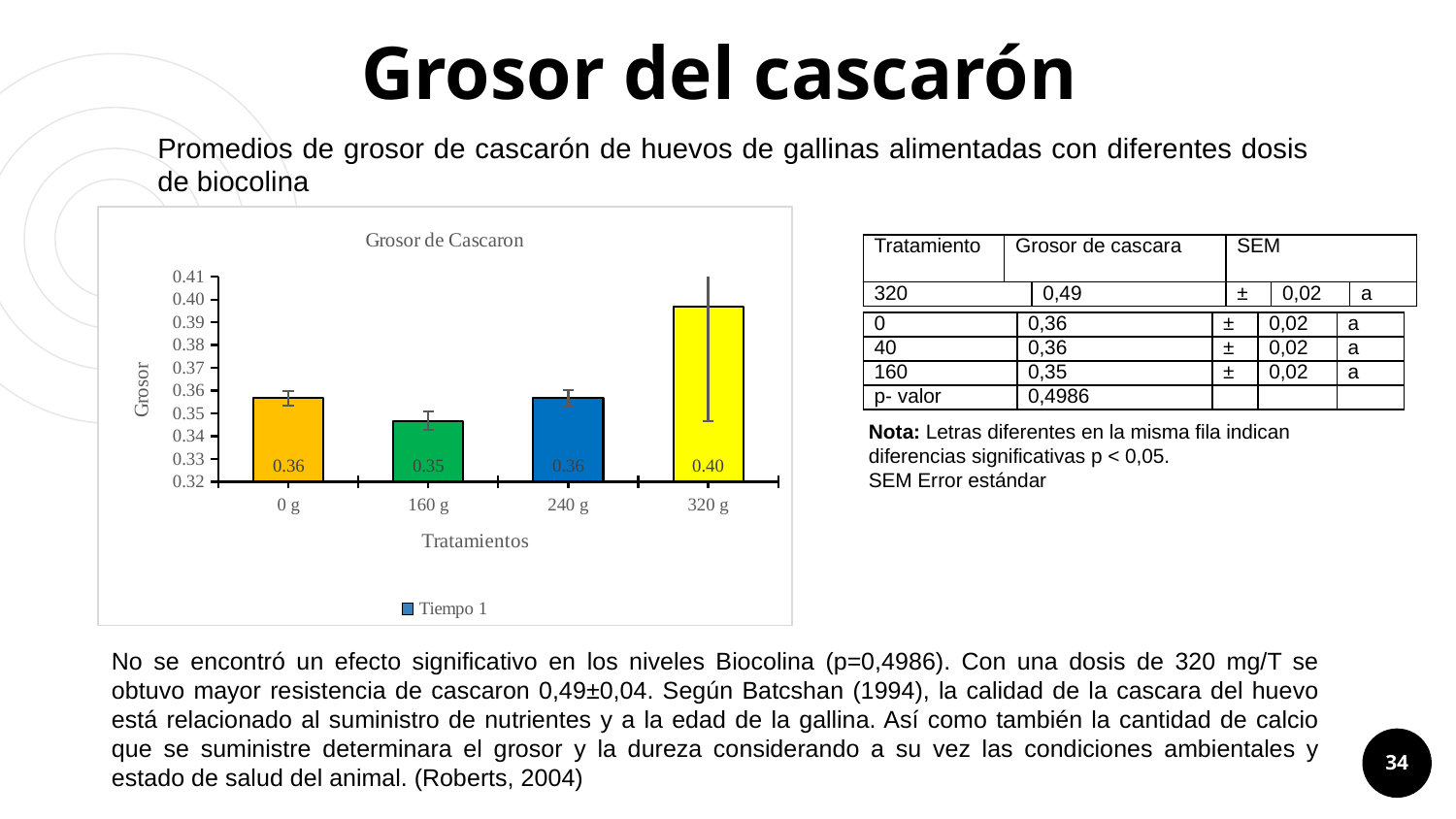
What is the difference between the values for 320 g and 160 g in the Grosor de Cascaron chart? 0.05 How many treatments are shown in the Grosor de Cascaron chart? 4 Which is larger in the Grosor de Cascaron chart, the value for 320 g or the value for 160 g? 320 g What is the difference between the values for 320 g and 240 g in the Grosor de Cascaron chart? 0.04 What is the value for the 320 g treatment in the Grosor de Cascaron chart? 0.40 What is the value for the 160 g treatment in the Grosor de Cascaron chart? 0.35 Which treatment has the highest value in the Grosor de Cascaron chart? 320 g What is the label on the x axis of the Grosor de Cascaron chart? Tratamientos What is the value for the 0 g treatment in the Grosor de Cascaron chart? 0.36 Is the value for 320 g in the Grosor de Cascaron chart greater or less than 0.38? greater What kind of chart is the Grosor de Cascaron chart? bar chart Which treatment has the lowest value in the Grosor de Cascaron chart? 160 g